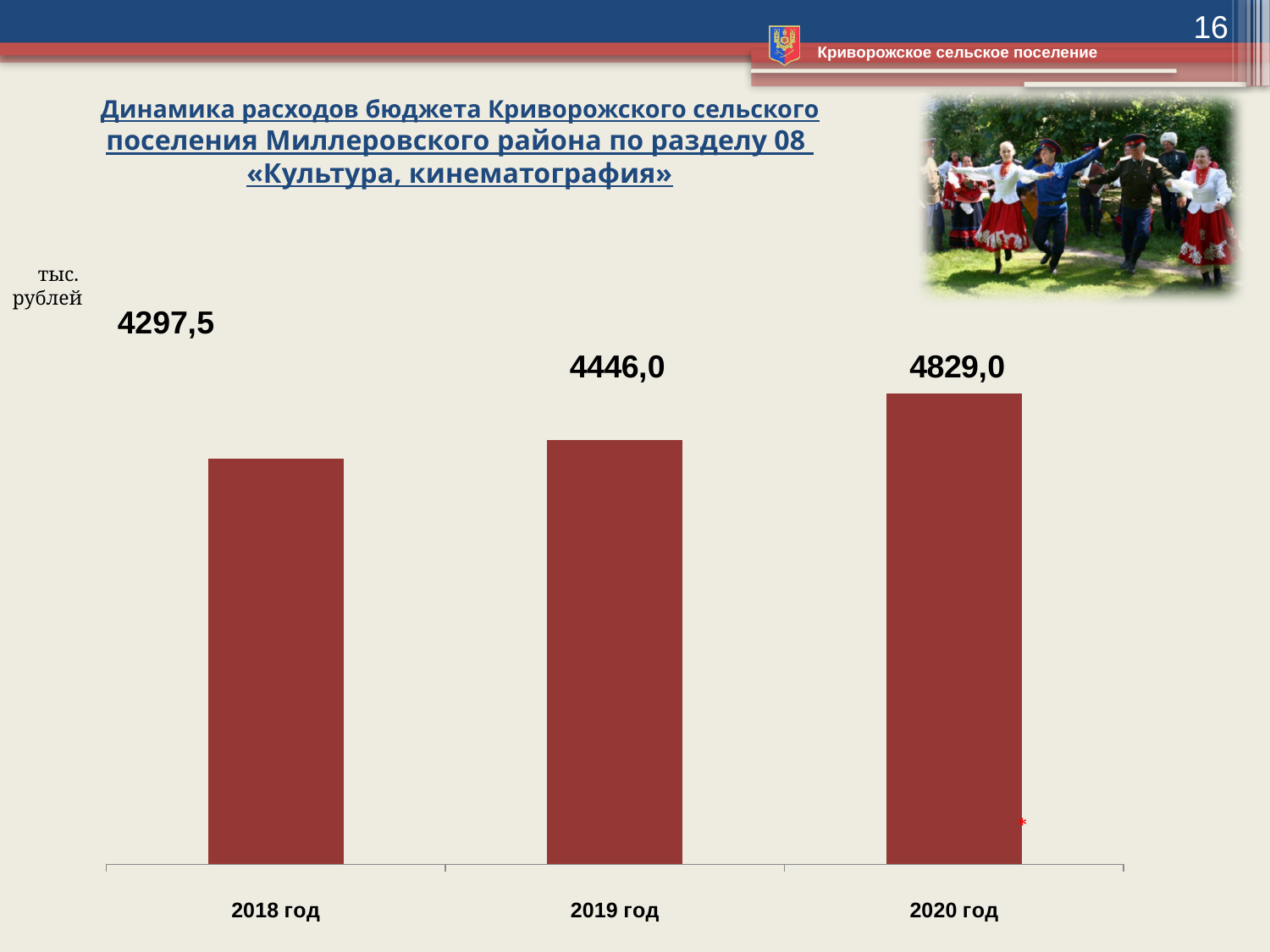
What is the value for 2019 год? 4446,0 Which is larger, the value for 2018 год or 2020 год? 2020 год What is the value for 2018 год? 4297,5 How many years are shown on the chart? 3 What is the value for 2020 год? 4829,0 What is the difference between the values for 2019 год and 2018 год? 148,5 Do the values rise or fall from 2018 год to 2020 год? rise In what units are the values on the chart expressed? тыс. рублей What kind of chart is shown on the slide? bar chart Which year has the highest value? 2020 год Which year has the lowest value? 2018 год What is the difference between the values for 2020 год and 2019 год? 383,0